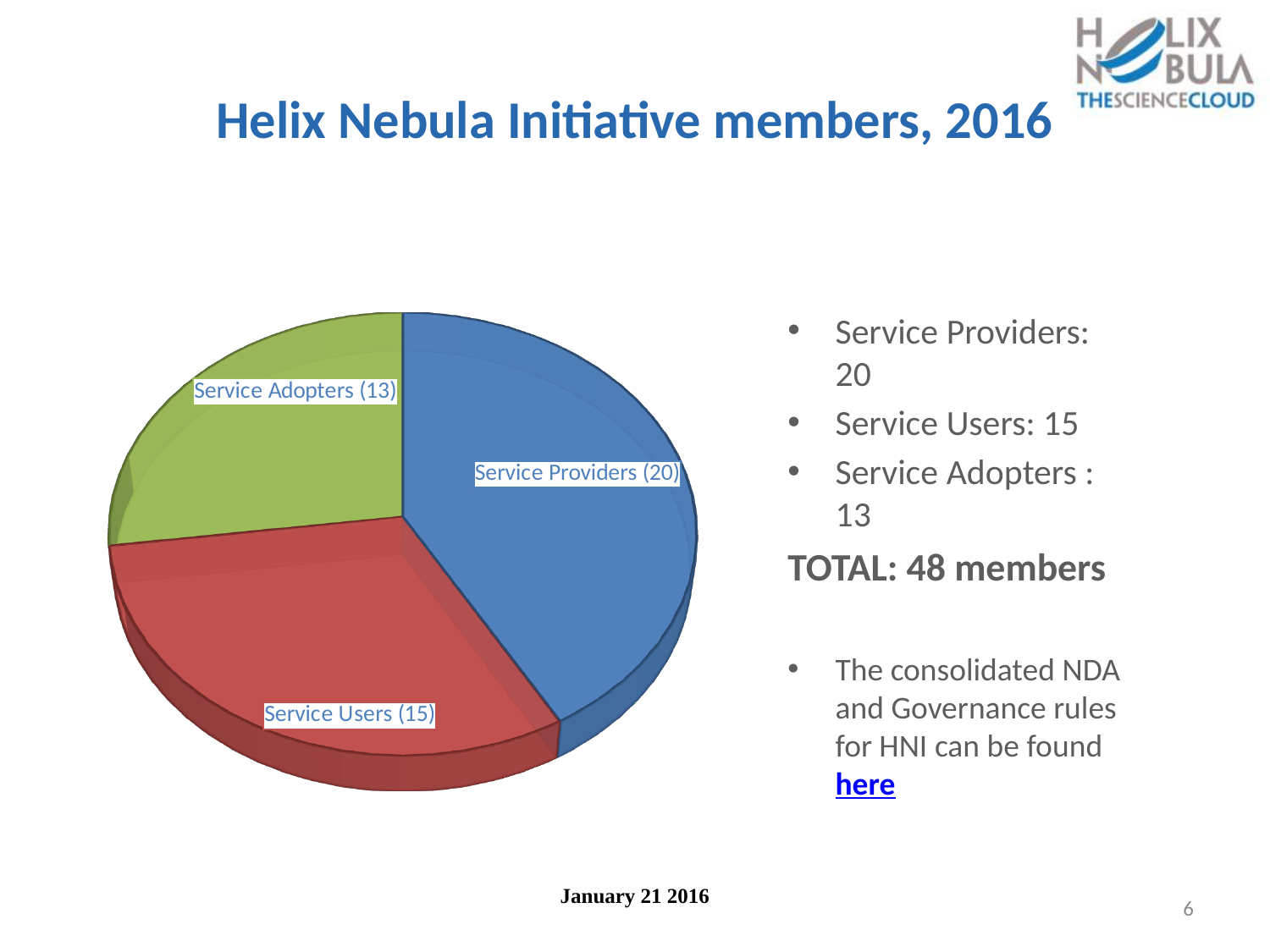
What kind of chart is shown on the slide? pie chart What is the difference between the Service Providers and Service Adopters values? 7 How many slices does the pie chart have? 3 Which is larger, Service Users or Service Adopters? Service Users Which category has the smallest slice in the pie chart? Service Adopters What is the difference between the Service Users and Service Adopters values? 2 What is the value for Service Users in the pie chart? 15 What colour is the Service Users slice in the pie chart? red Which category has the largest slice in the pie chart? Service Providers What is the value for Service Adopters in the pie chart? 13 What is the value for Service Providers in the pie chart? 20 What is the total of all slices in the pie chart? 48